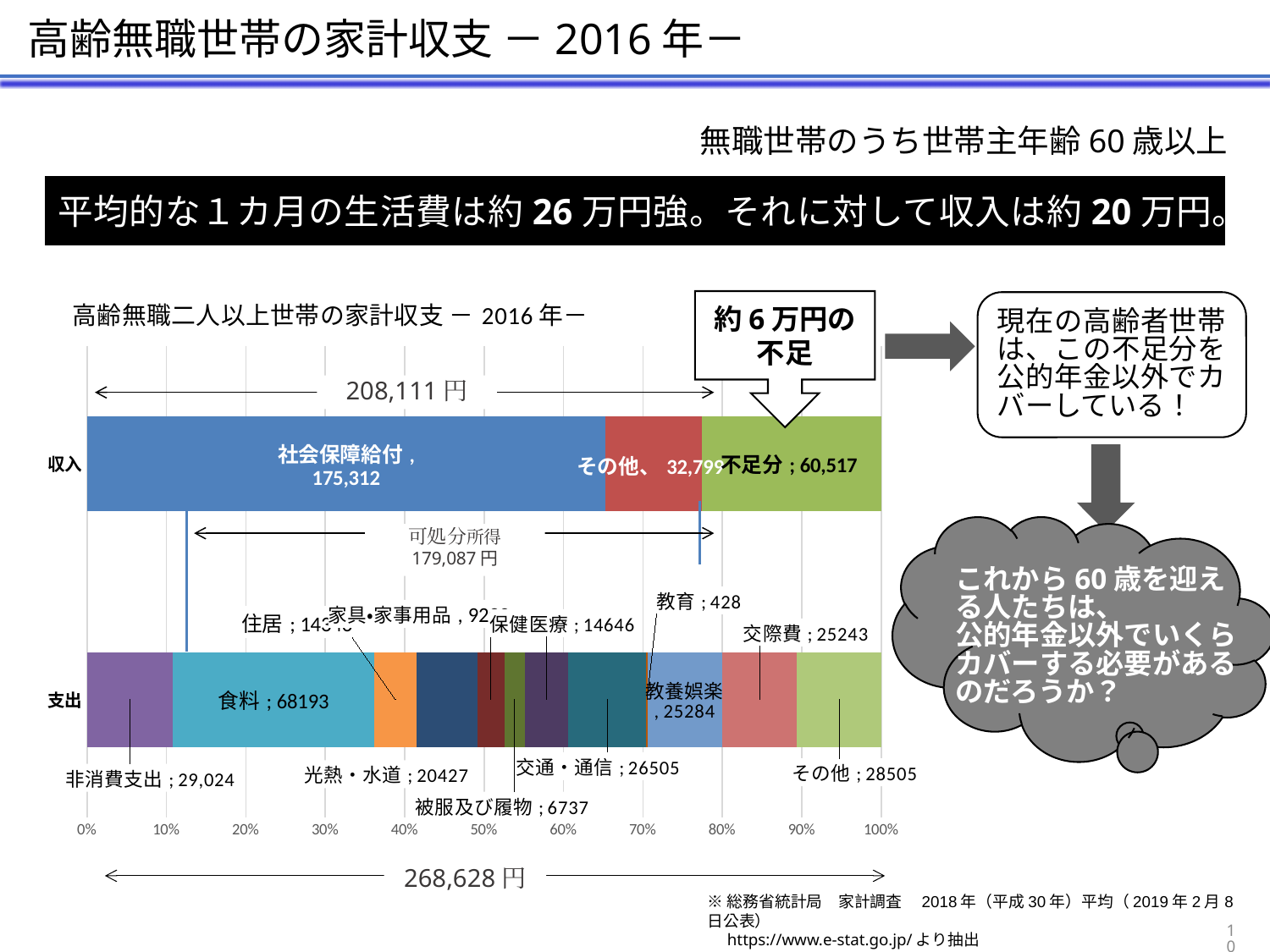
How many bars (categories) does the chart have? 2 What is the value of 教育 in the 支出 bar? 428 What is the value of 食料 in the 支出 bar? 68193 Which segment of the 支出 bar has the smallest value? 教育 What is the value of 非消費支出 in the 支出 bar? 29,024 What total amount is shown for the 支出 bar below the chart? 268,628 円 What is the value of 社会保障給付 in the 収入 bar? 175,312 What kind of chart is shown on the slide? Stacked bar chart Which segment of the 支出 bar has the largest value? 食料 What is the difference between 社会保障給付 and 不足分 in the 収入 bar? 114,795 What is the value of 不足分 in the 収入 bar? 60,517 Which is larger in the 支出 bar, 交通・通信 or 光熱・水道? 交通・通信